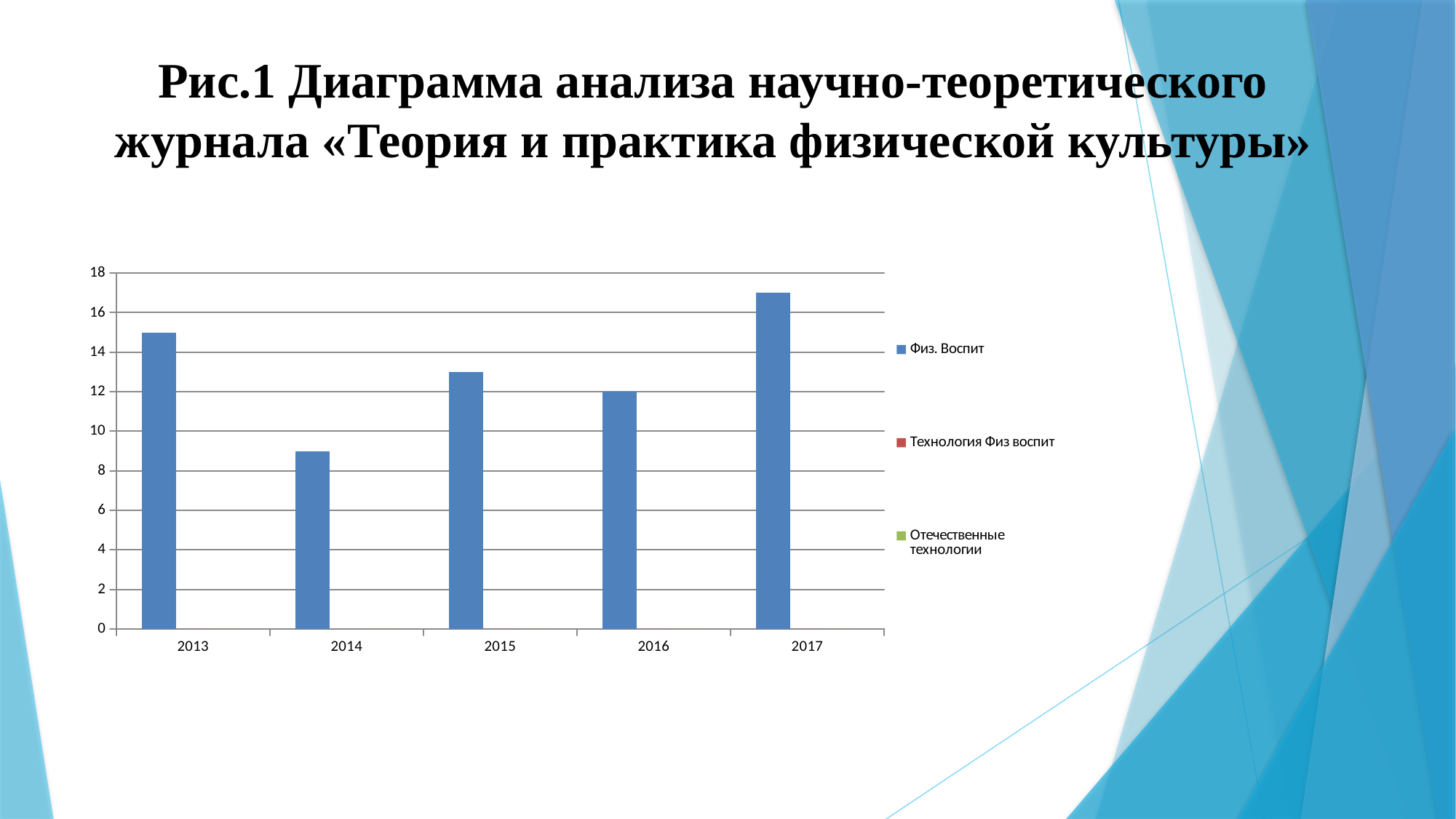
What kind of chart is shown on the slide? bar chart Which legend entry is shown with a blue marker? Физ. Воспит Does the value rise or fall from 2013 to 2014? fall How many series does the chart's legend list? 3 Which is larger, the bar for 2013 or the bar for 2015? 2013 Which year has the lowest bar in the chart? 2014 Is the value for 2014 greater or less than 10? less Is the value for 2013 greater or less than 14? greater Which year has the highest bar in the chart? 2017 Is the value for 2017 greater or less than 16? greater What is the value of the bar for 2016? 12 How many years are shown on the x axis of the chart? 5